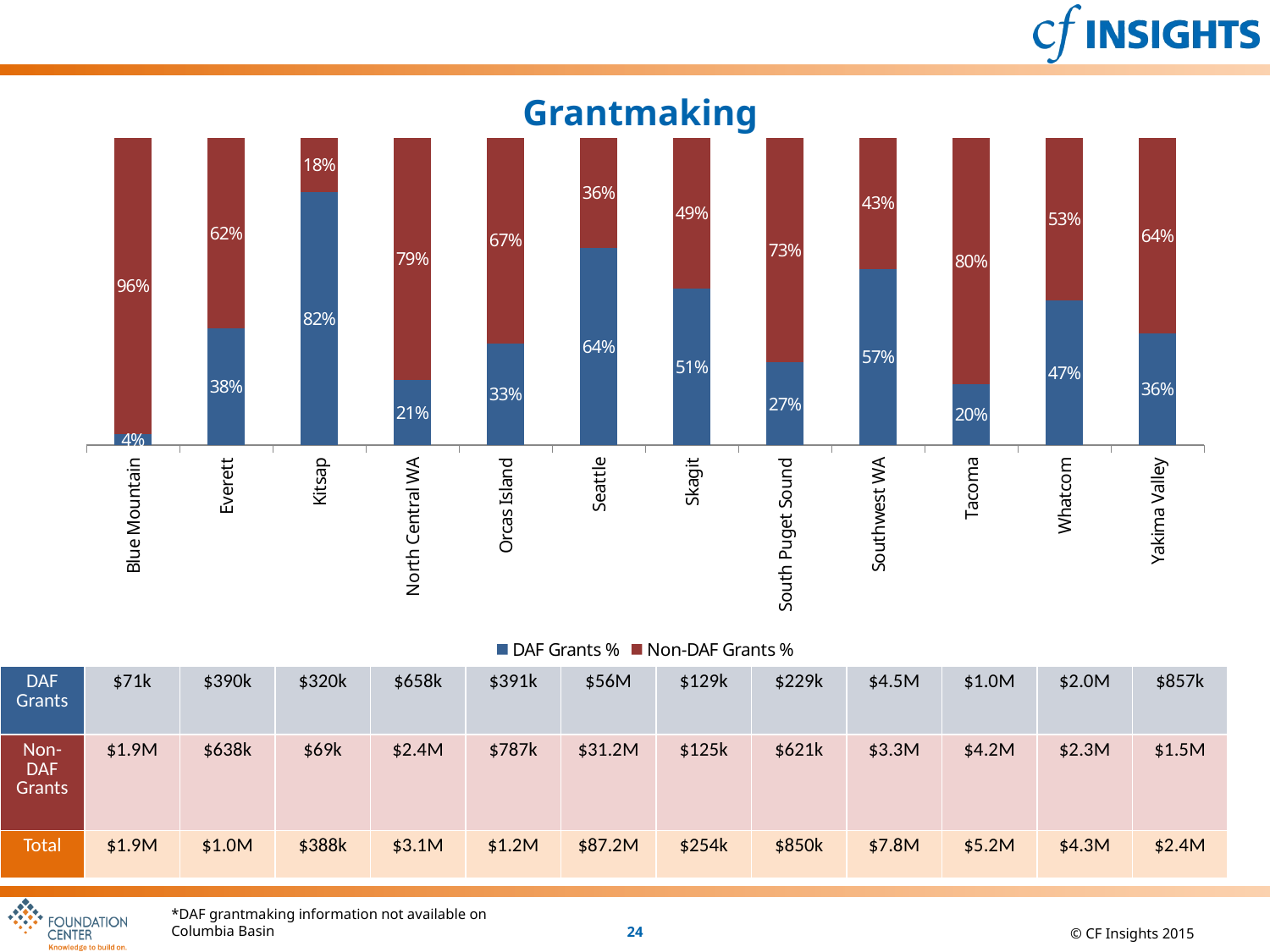
What is the title of the chart? Grantmaking What is the Non-DAF Grants % value for Tacoma? 80% Which category has the highest Non-DAF Grants % value? Blue Mountain Which category has the lowest DAF Grants % value? Blue Mountain How many series does the chart legend list? 2 What is the difference between the DAF Grants % values for Southwest WA and Whatcom? 10% What is the DAF Grants % value for Seattle? 64% How many categories are shown on the x axis of the chart? 12 Which is larger, the DAF Grants % for Everett or the DAF Grants % for Orcas Island? Everett What kind of chart is shown on the slide? Stacked bar chart Which category has the highest DAF Grants % value? Kitsap What is the DAF Grants % value for Kitsap? 82%